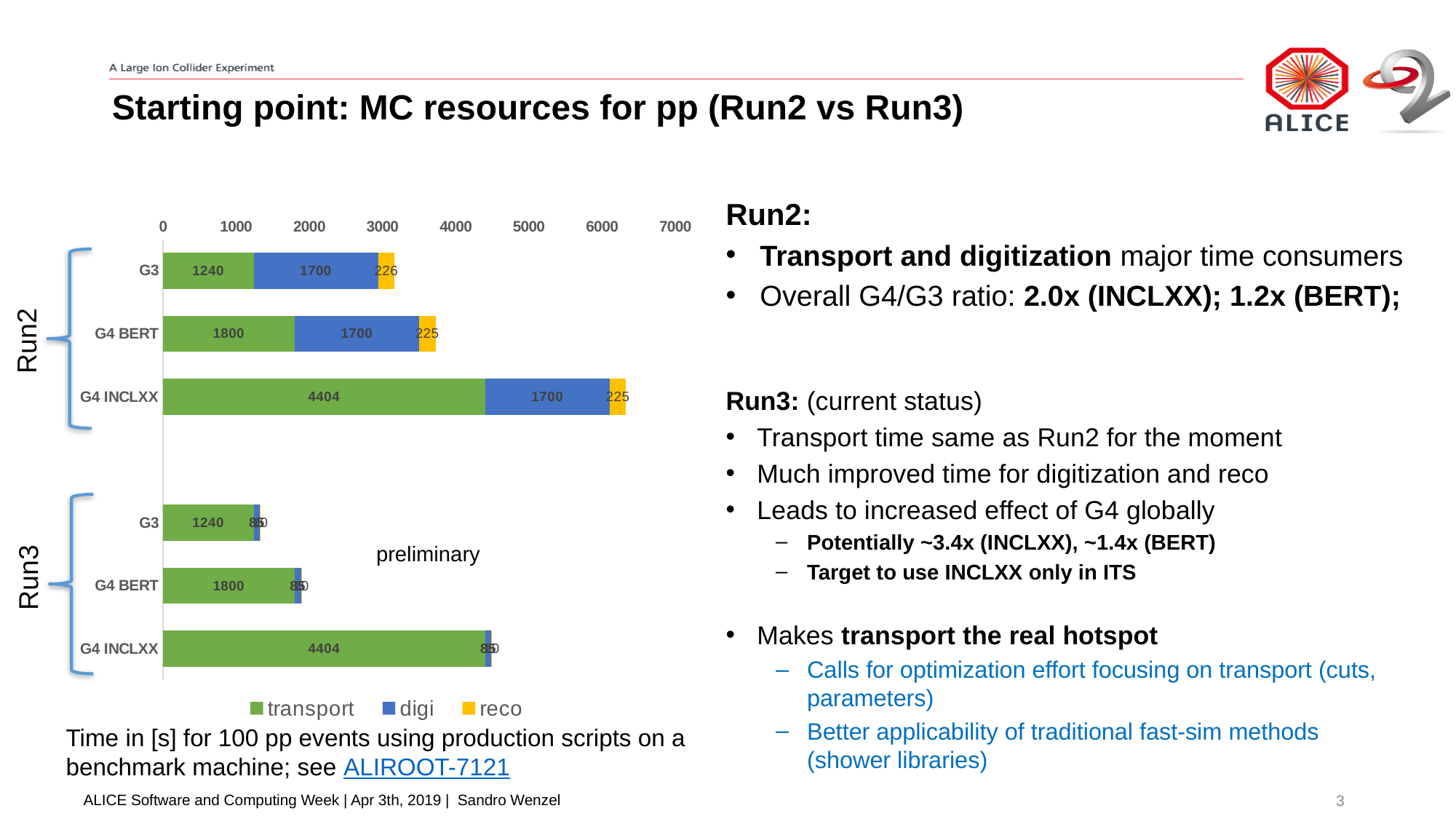
What is the total of the stacked bar for G4 BERT in Run2? 3725 How many bars are plotted in the chart? 6 What is the transport value for G4 INCLXX in Run2? 4404 Which configuration has the highest transport value? G4 INCLXX What is the digi value for G4 BERT in Run2? 1700 What is the reco value for G3 in Run2? 226 Is the transport value for G3 in Run2 larger or smaller than the transport value for G4 BERT in Run2? smaller Which series are listed in the chart legend? transport, digi, reco What kind of chart is shown on the slide? stacked bar chart What is the transport value for G4 BERT in Run3? 1800 What is the difference between the transport values of G4 BERT and G3 in Run2? 560 How many series does the chart legend list? 3